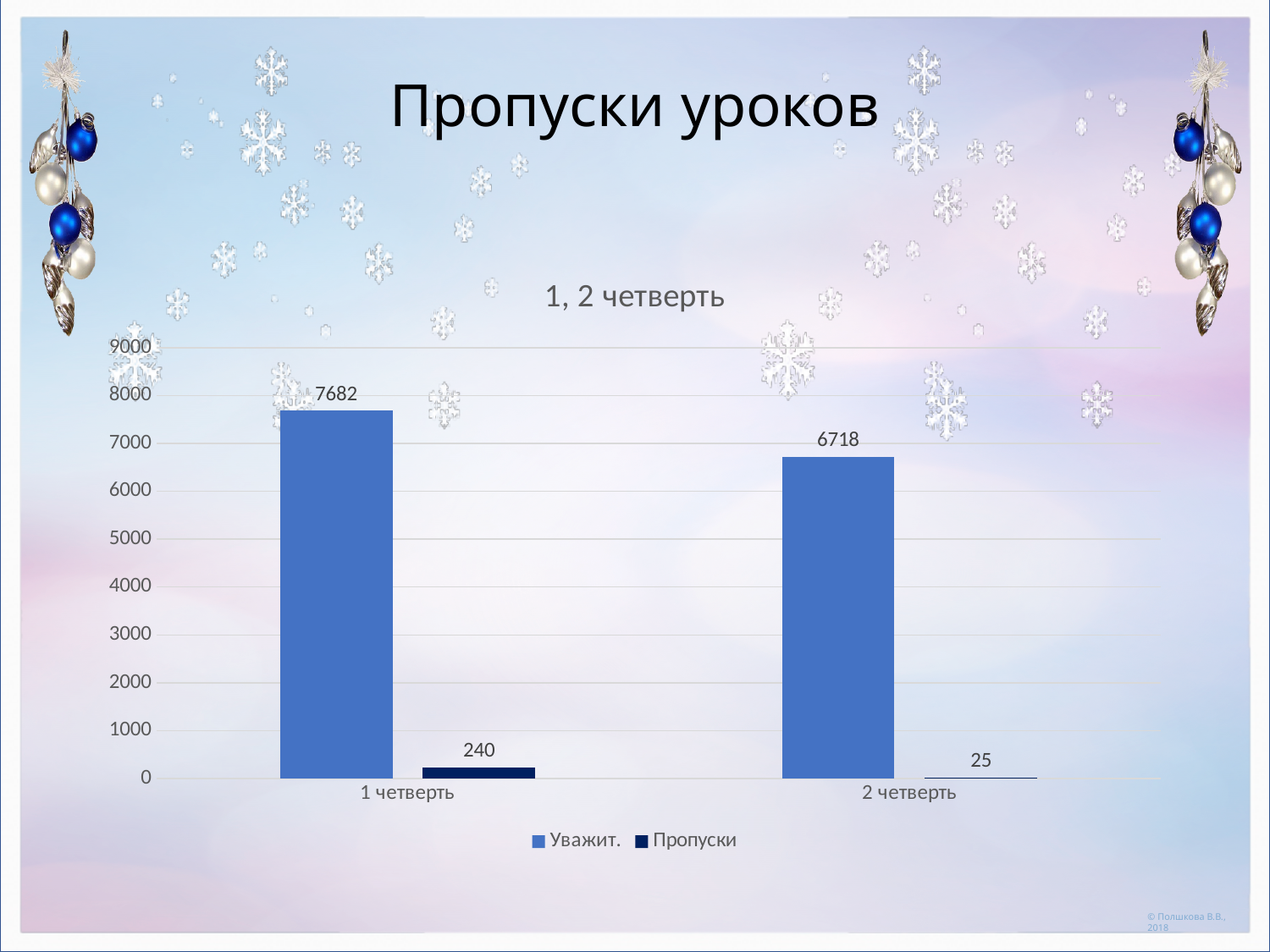
How many series does the legend list? 2 What is the title of the chart? 1, 2 четверть What is the value of Пропуски for 2 четверть? 25 What is the difference between the Уважит. values for 1 четверть and 2 четверть? 964 What is the difference between the Пропуски values for 1 четверть and 2 четверть? 215 Is the Уважит. value for 2 четверть greater or less than 7000? less What is the value of Уважит. for 1 четверть? 7682 What is the value of Уважит. for 2 четверть? 6718 What is the value of Пропуски for 1 четверть? 240 What kind of chart is shown on the slide? bar chart Which category has the lower Пропуски value? 2 четверть Which category has the higher Уважит. value? 1 четверть